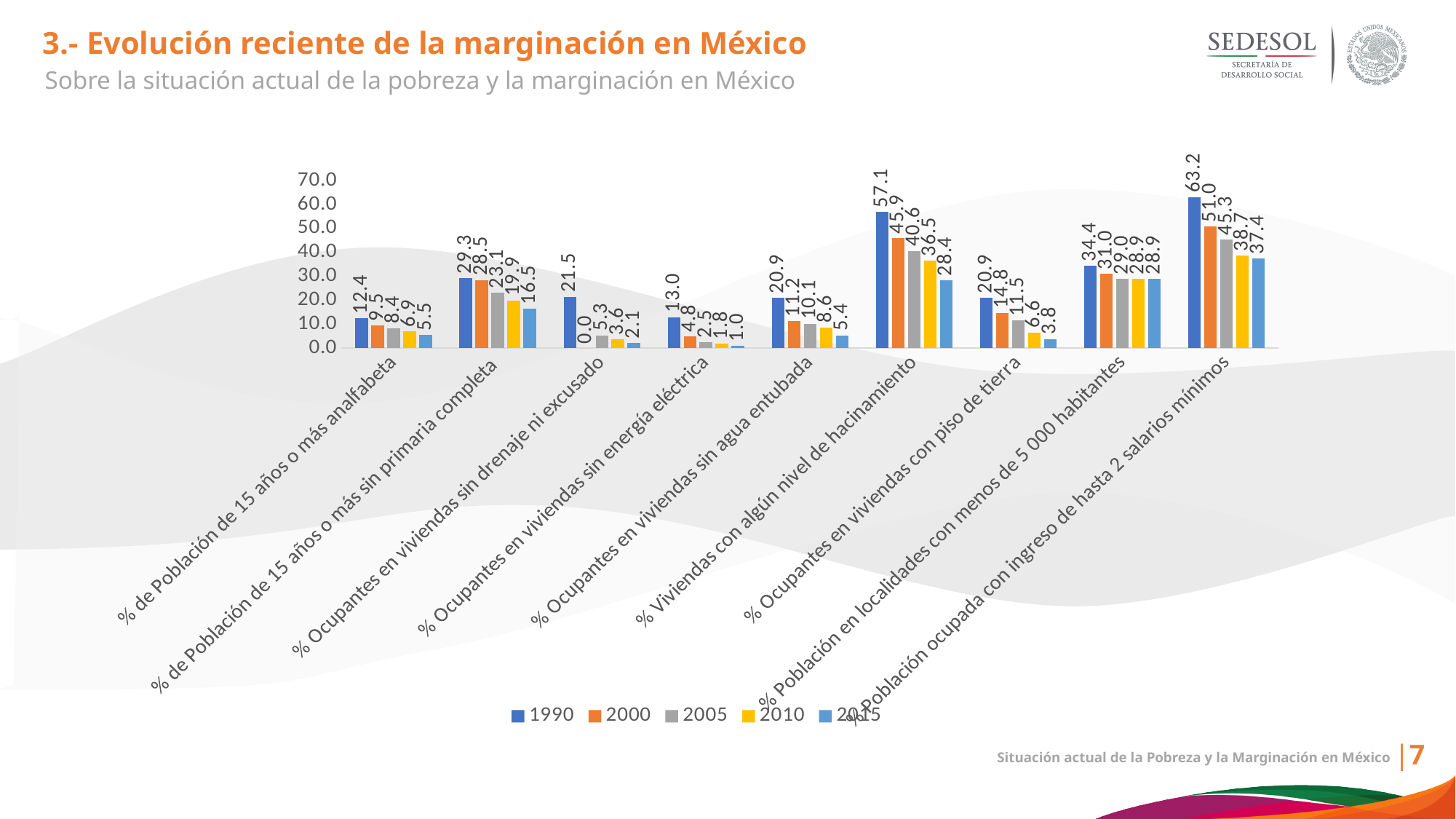
How many series does the legend list? 5 What is the 1990 value for % Viviendas con algún nivel de hacinamiento? 57.1 What is the difference between the 1990 and 2015 values for % Viviendas con algún nivel de hacinamiento? 28.7 What is the 2010 value for % Población ocupada con ingreso de hasta 2 salarios mínimos? 38.7 How many categories are shown on the x axis? 9 Do the values for % de Población de 15 años o más sin primaria completa rise or fall from 1990 to 2015? Fall Which category has the highest 1990 value? % Población ocupada con ingreso de hasta 2 salarios mínimos What is the 2000 value for % Ocupantes en viviendas sin drenaje ni excusado? 0.0 What is the 2015 value for % de Población de 15 años o más analfabeta? 5.5 Which is larger for % Ocupantes en viviendas con piso de tierra: the 2000 value or the 2005 value? 2000 What kind of chart is shown on the slide? Bar chart Which category has the lowest 2015 value? % Ocupantes en viviendas sin energía eléctrica